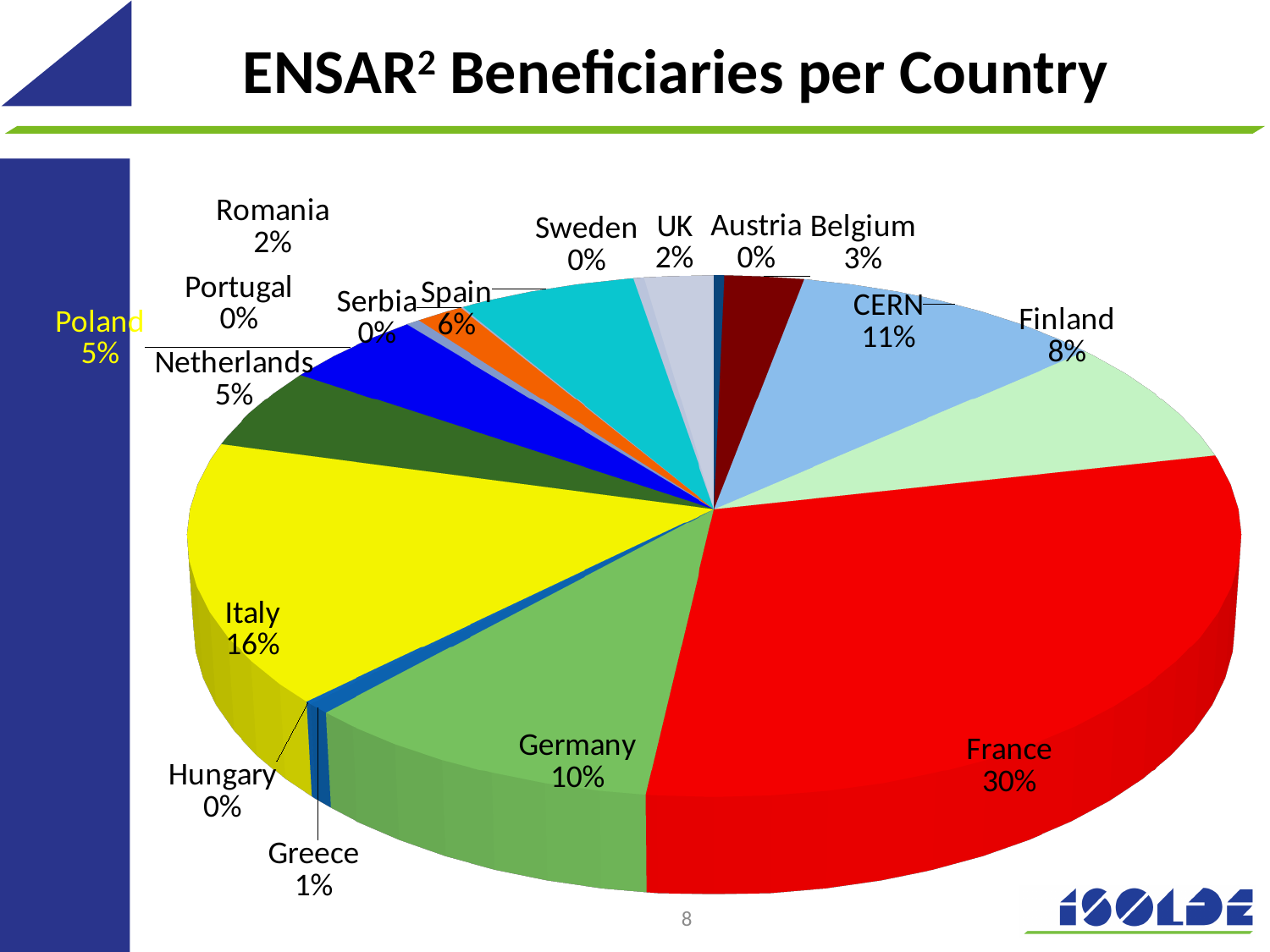
What percentage is shown for Greece? 1% What percentage is shown for Italy? 16% What is the title of the chart on the slide? ENSAR² Beneficiaries per Country What share of ENSAR² beneficiaries does France account for? 30% How many categories are labelled on the pie chart? 17 Which has a larger share, Finland or Spain? Finland What percentage is shown for Belgium? 3% Which country has the largest share of beneficiaries? France What is the difference in percentage points between France and Germany? 20 What percentage is shown for CERN? 11% What colour is the France slice of the pie chart? red What kind of chart is shown on the slide? pie chart